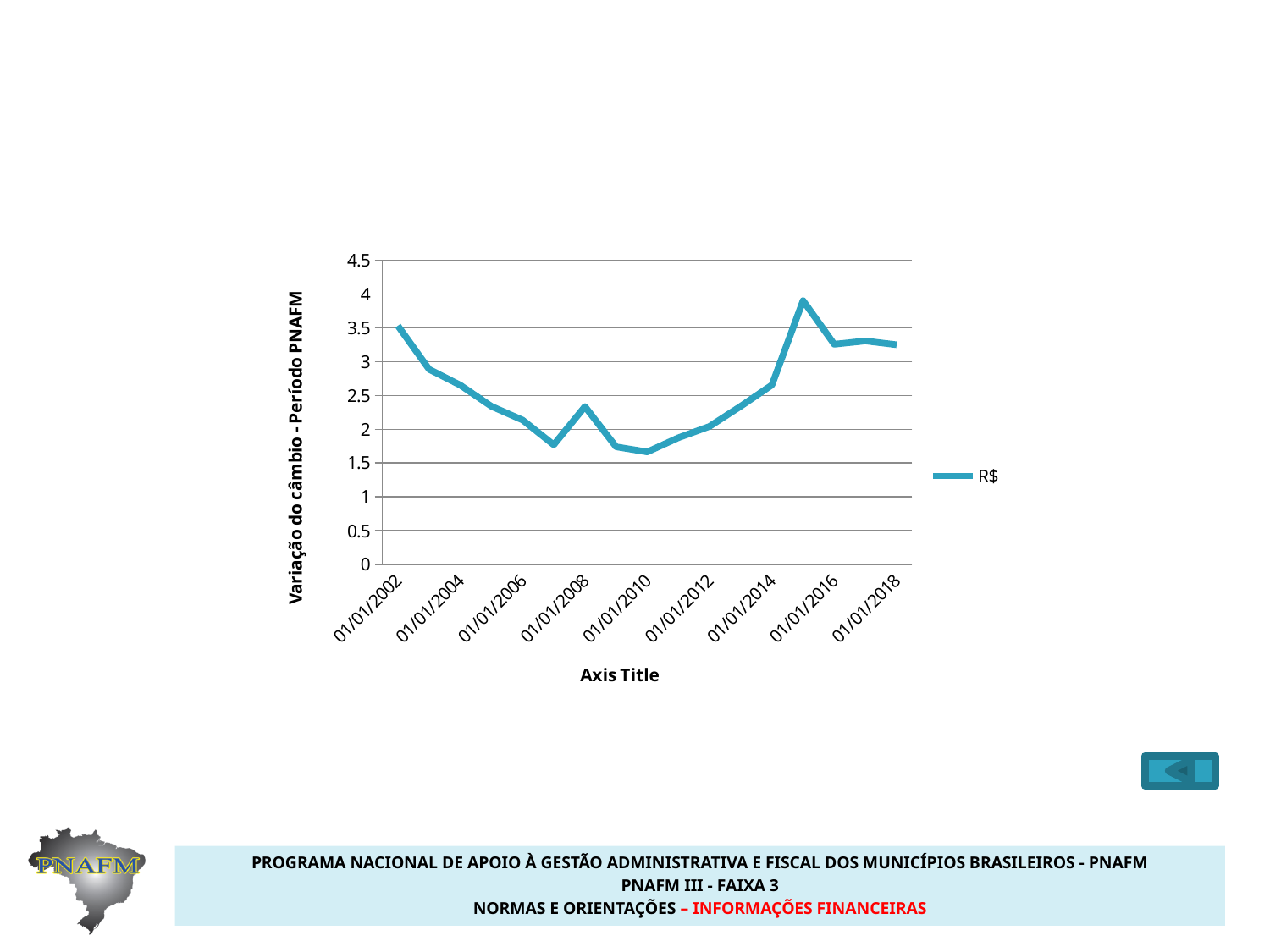
Which is larger, the value for 01/01/2018 or the value for 01/01/2008? 01/01/2018 Which is larger, the value for 01/01/2002 or the value for 01/01/2010? 01/01/2002 What kind of chart is shown on the slide? line chart Is the value for 01/01/2006 greater or less than 2.5? less What is the name of the series shown in the legend? R$ How many date labels are shown on the horizontal axis? 9 What is the title of the vertical axis? Variação do câmbio - Período PNAFM Is the value for 01/01/2004 greater or less than 2.5? greater Is the value for 01/01/2016 greater or less than 3? greater How many series does the legend list? 1 Does the line generally rise or fall between 01/01/2002 and 01/01/2010? fall